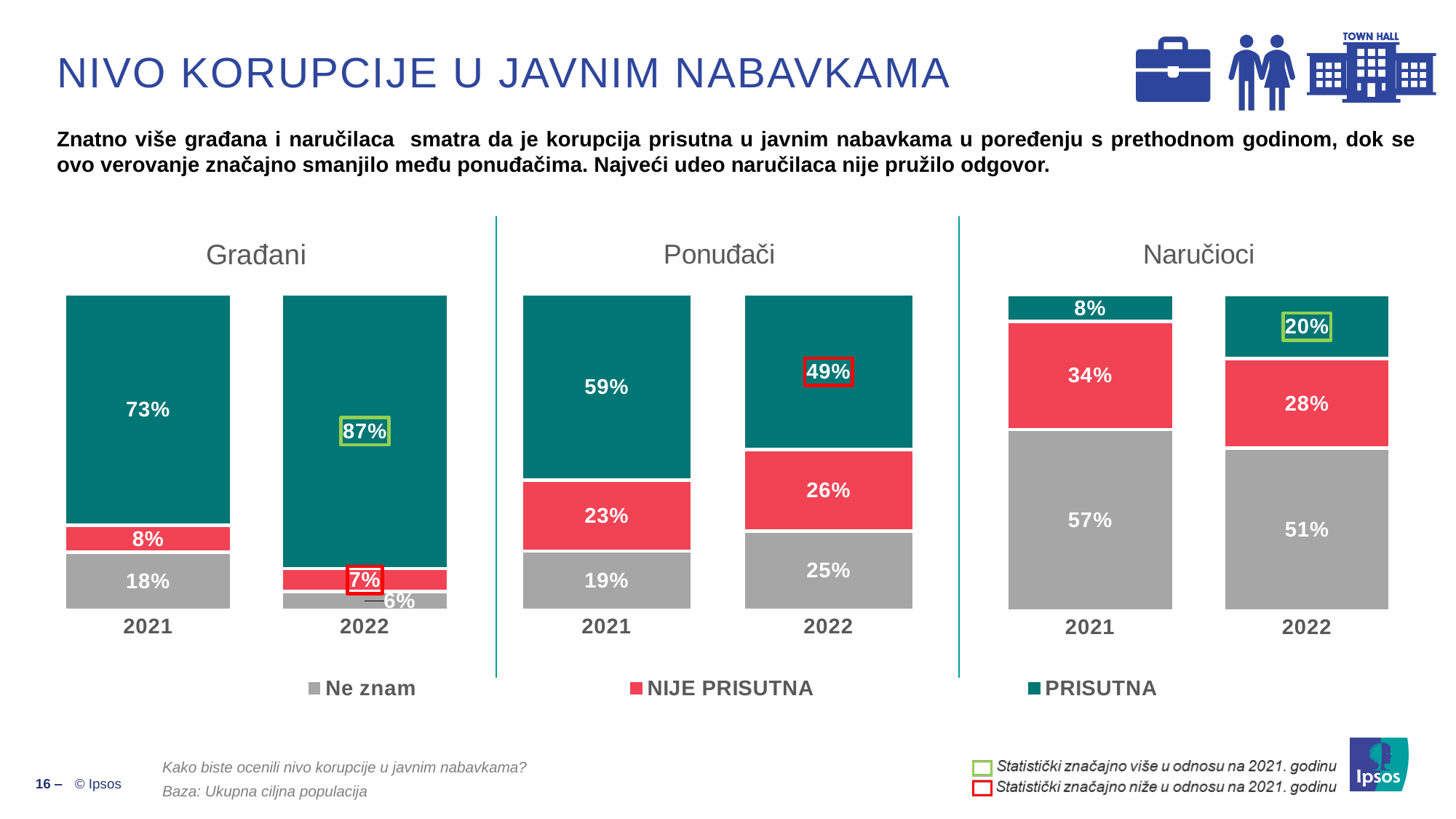
Which colour represents the PRISUTNA series in the legend? teal (dark green) In the Naručioci chart, what is the NIJE PRISUTNA value for 2022? 28% In the Ponuđači chart, what is the PRISUTNA value for 2021? 59% What kind of chart is used for the Naručioci data? stacked bar chart In the Građani chart, what is the Ne znam value for 2021? 18% In the Ponuđači chart, by how many percentage points did the PRISUTNA value change from 2021 to 2022? 10 percentage points lower In the Građani chart, what is the PRISUTNA value for 2022? 87% In the Građani chart, does the PRISUTNA value rise or fall from 2021 to 2022? rise In the Naručioci chart, what is the Ne znam value for 2021? 57% In the Ponuđači chart, what is the difference between the Ne znam values for 2022 and 2021? 6 percentage points How many series does the legend list? 3 In the Naručioci chart, which year has the higher PRISUTNA value, 2021 or 2022? 2022